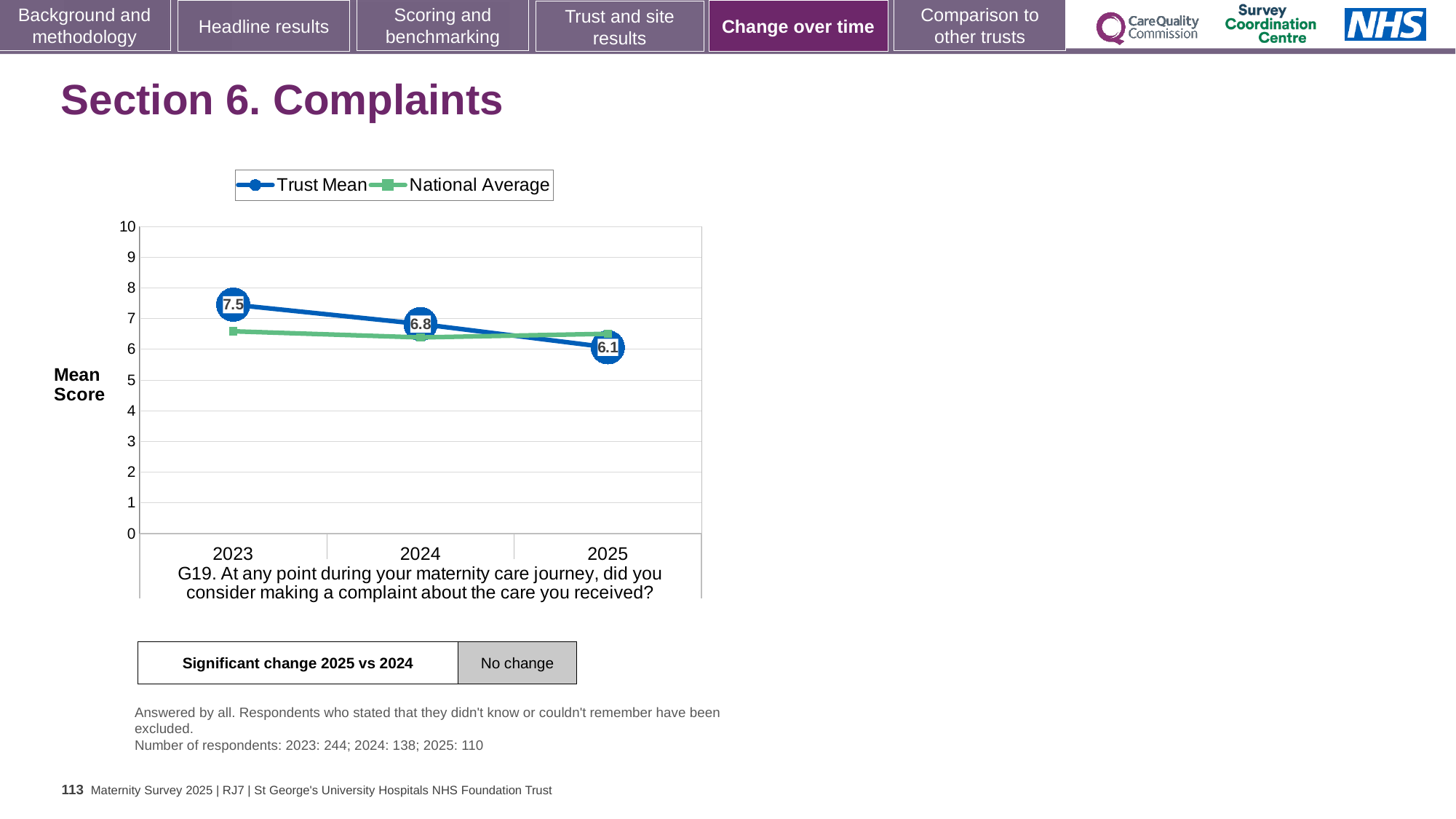
What is the Trust Mean score for 2025? 6.1 In 2025, which is higher: the Trust Mean or the National Average? National Average Does the Trust Mean rise or fall from 2023 to 2025? fall What is the Trust Mean score for 2024? 6.8 Is the National Average for 2025 greater or less than 6? greater In which year is the Trust Mean highest? 2023 What is the difference between the Trust Mean in 2023 and in 2025? 1.4 In which year is the Trust Mean lowest? 2025 Is the National Average for 2023 greater or less than 7? less What is the Trust Mean score for 2023? 7.5 How many series does the legend list? 2 What kind of chart is shown on the slide? line chart